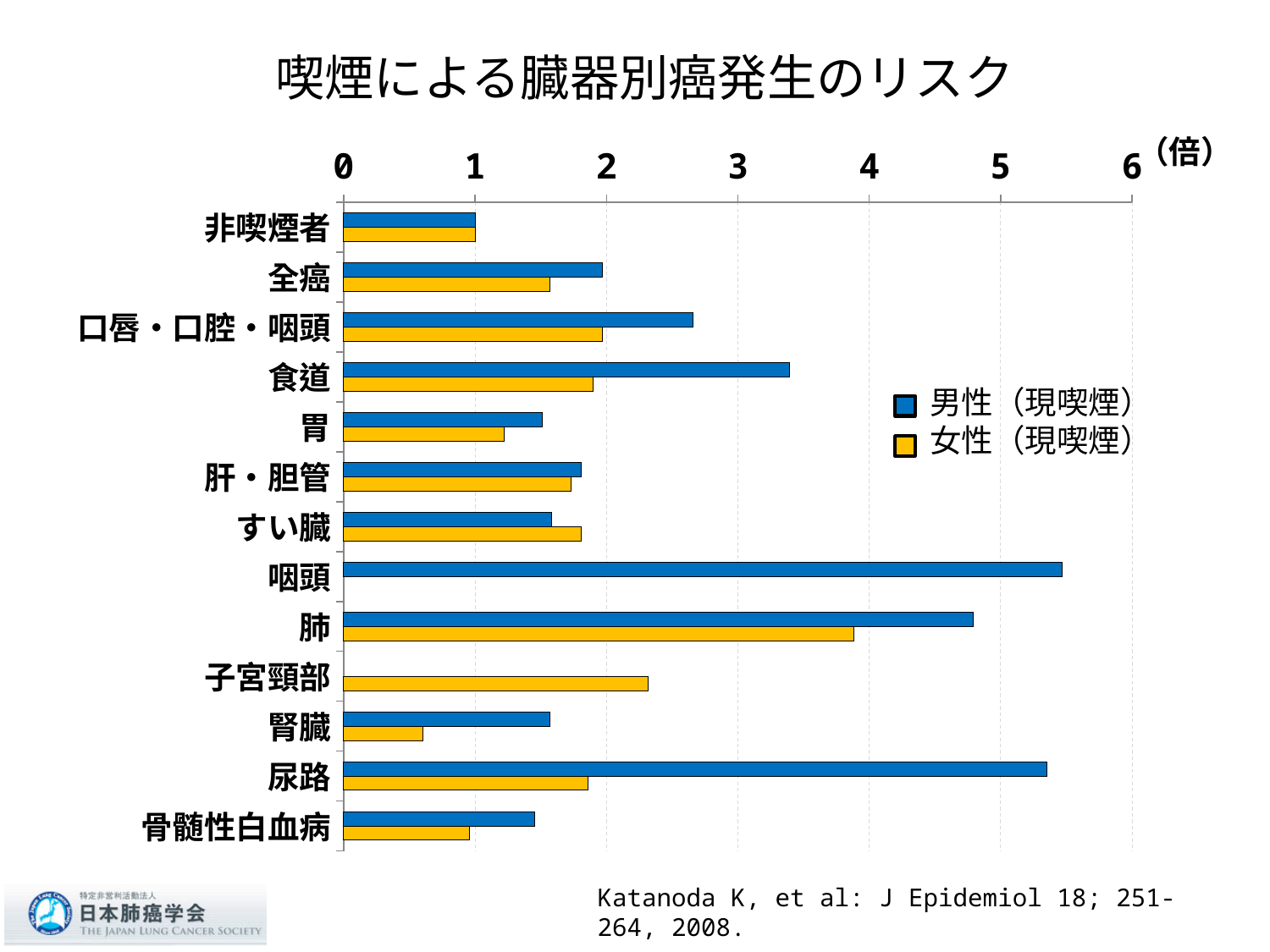
What is the title of the chart? 喫煙による臓器別癌発生のリスク How many categories are shown on the vertical axis? 13 Which category has the highest value in the 女性（現喫煙） series? 肺 What is the value for 非喫煙者 in the 男性（現喫煙） series? 1 What kind of chart is shown on the slide? bar chart Is the value for 腎臓 in the 女性（現喫煙） series greater or less than 1? less Which category has the lowest value in the 女性（現喫煙） series? 腎臓 For 肺, which series has the larger value, 男性（現喫煙） or 女性（現喫煙）? 男性（現喫煙） Is the value for 食道 in the 男性（現喫煙） series greater or less than 3? greater Is the value for 咽頭 in the 男性（現喫煙） series greater or less than 5? greater How many series does the legend list? 2